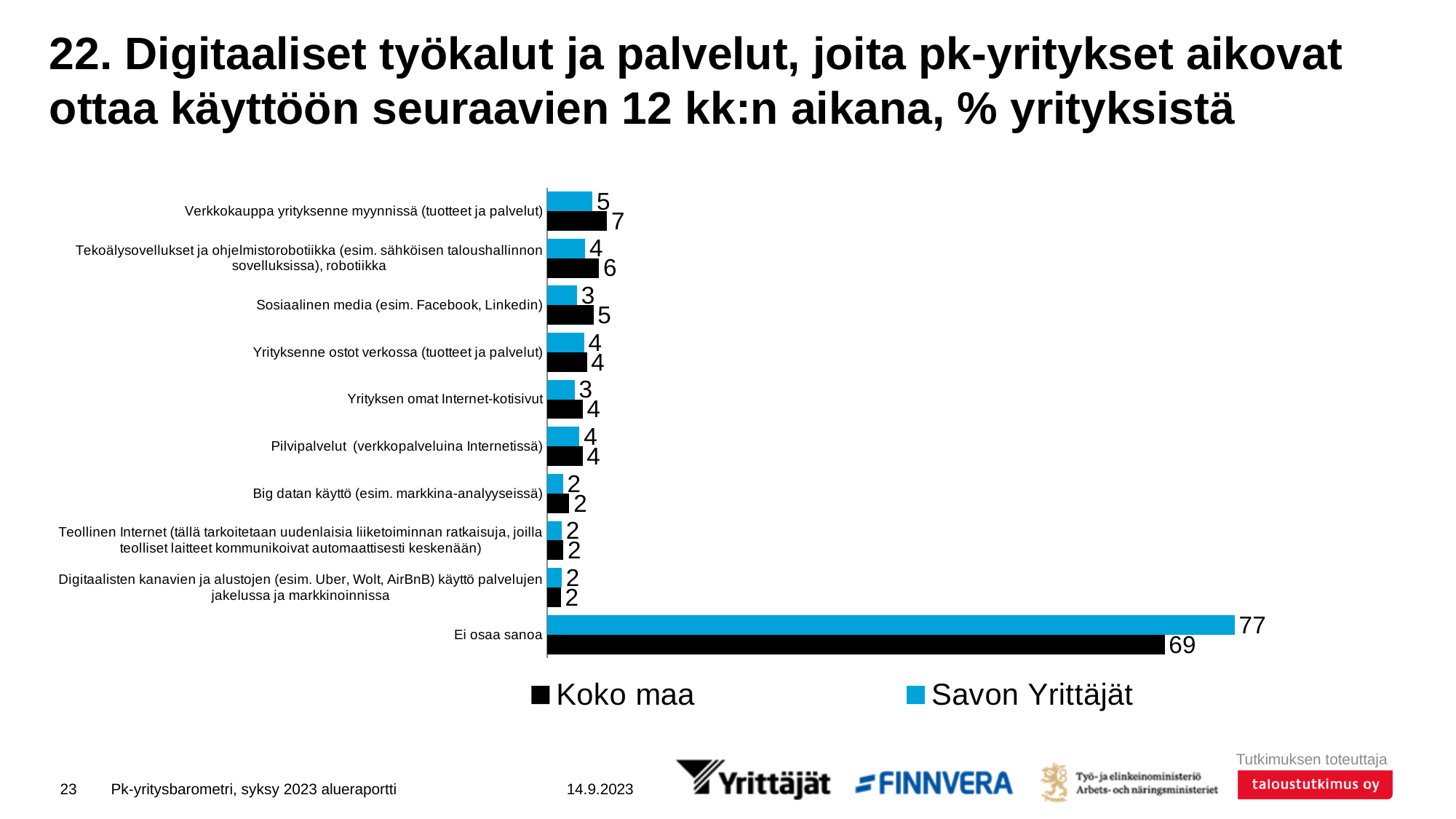
What is the value for Savon Yrittäjät for "Ei osaa sanoa"? 77 What is the difference between the Koko maa and Savon Yrittäjät values for "Verkkokauppa yrityksenne myynnissä (tuotteet ja palvelut)"? 2 What is the value for Savon Yrittäjät for "Sosiaalinen media (esim. Facebook, Linkedin)"? 3 What is the difference between the Savon Yrittäjät and Koko maa values for "Ei osaa sanoa"? 8 For "Sosiaalinen media (esim. Facebook, Linkedin)", which series has the larger value, Koko maa or Savon Yrittäjät? Koko maa What is the value for Koko maa for "Verkkokauppa yrityksenne myynnissä (tuotteet ja palvelut)"? 7 Which category has the highest value for Savon Yrittäjät? Ei osaa sanoa How many series does the legend list? 2 How many categories are shown on the chart? 10 What is the value for Koko maa for "Ei osaa sanoa"? 69 What is the value for Koko maa for "Tekoälysovellukset ja ohjelmistorobotiikka (esim. sähköisen taloushallinnon sovelluksissa), robotiikka"? 6 What kind of chart is shown on the slide? Bar chart